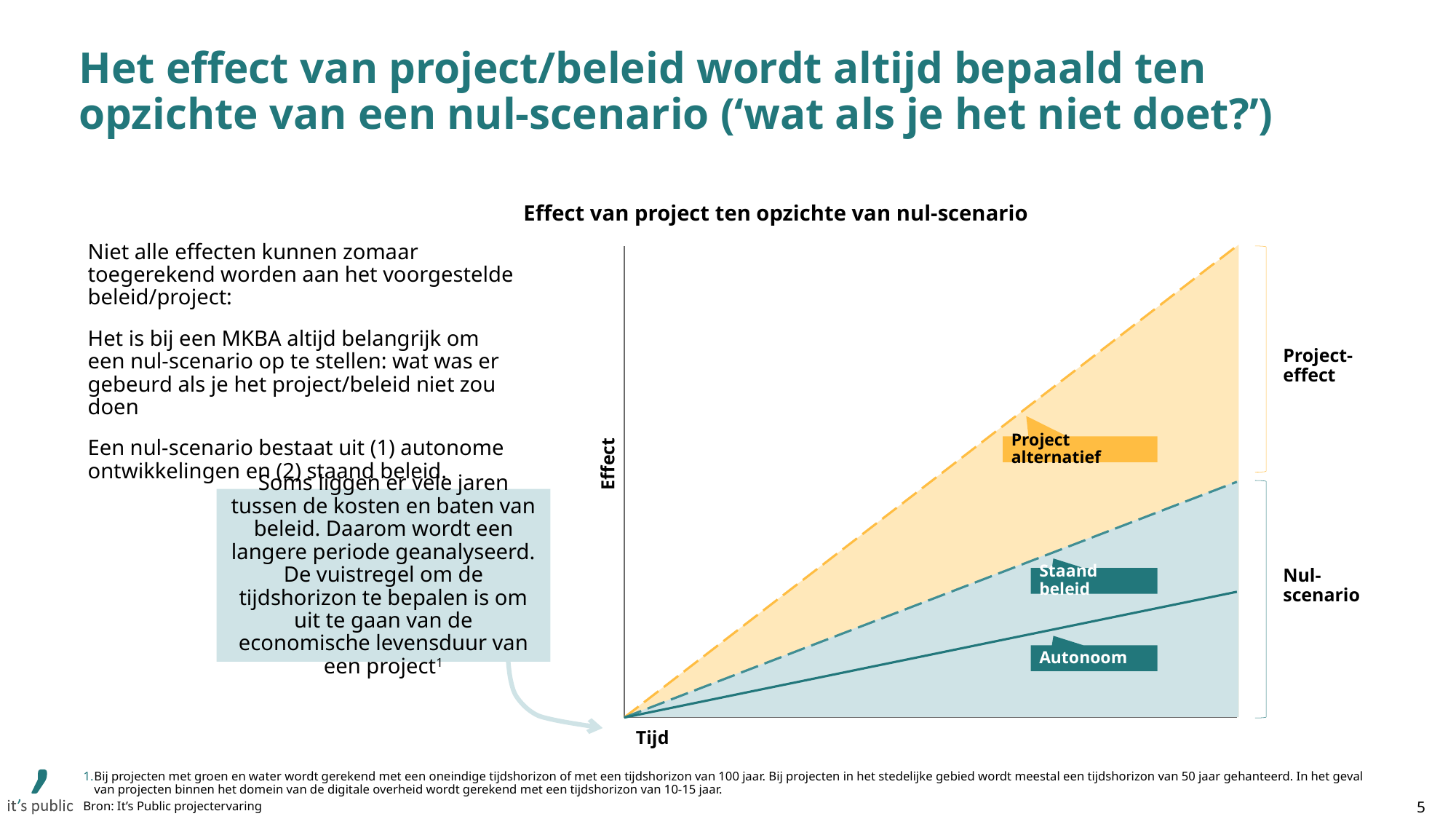
At the right end of the chart, which line is higher: Staand beleid or Autonoom? Staand beleid What is the title of the chart? Effect van project ten opzichte van nul-scenario Do the lines in the chart rise or fall as time (Tijd) increases? Rise Which line has the lowest effect at the right end of the chart? Autonoom At the right end of the chart, which line is higher: Project alternatief or Staand beleid? Project alternatief Which line in the chart is drawn as a solid (not dashed) line? Autonoom What is the label of the horizontal axis of the chart? Tijd What kind of chart is shown on the slide? Line chart How many lines are plotted in the chart? 3 Which line reaches the highest effect at the right end of the chart? Project alternatief